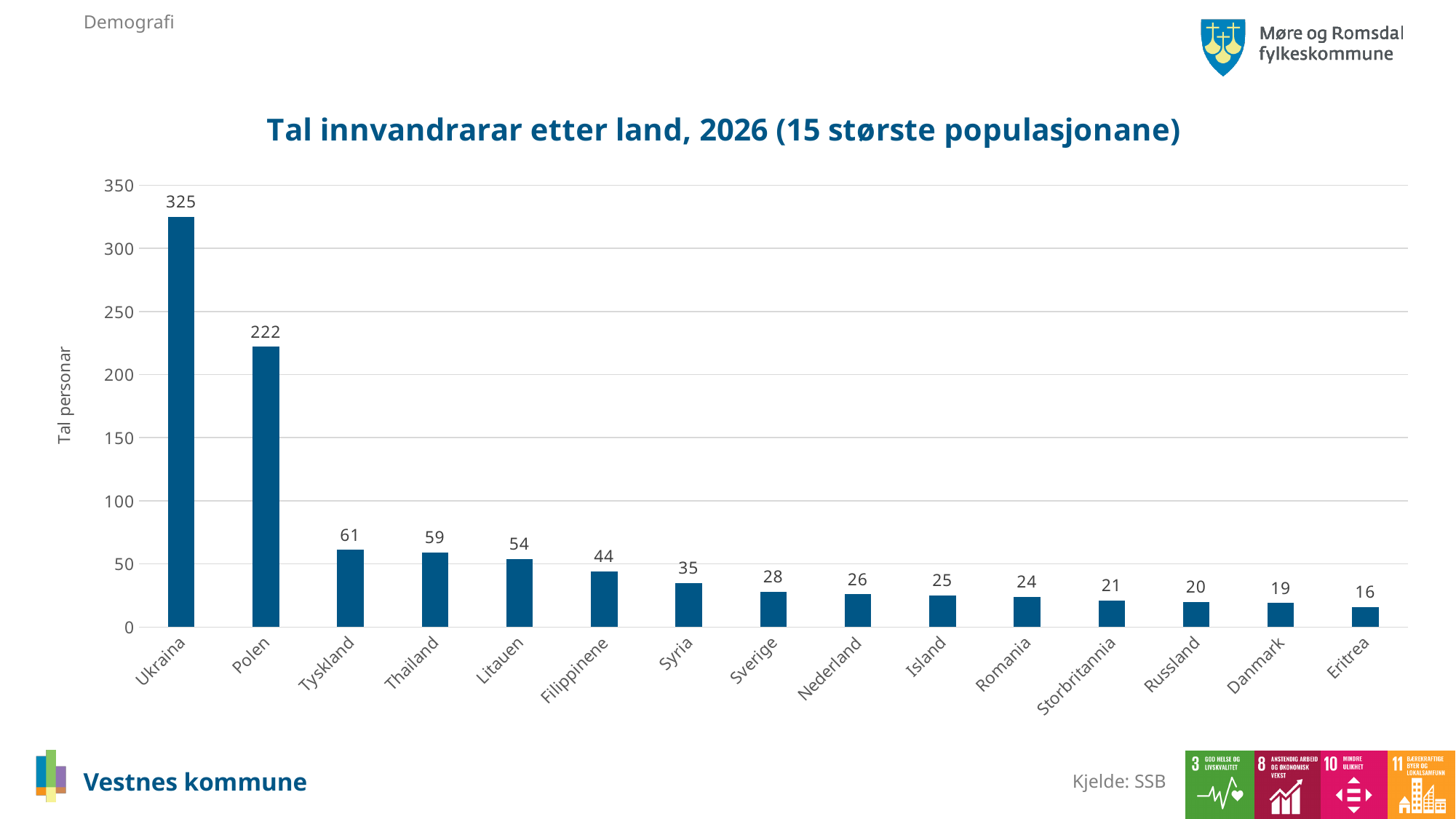
Which country has the lowest value? Eritrea What is the value for Thailand? 59 How many countries are shown on the chart? 15 What is the value for Storbritannia? 21 Which is larger, the value for Syria or the value for Sverige? Syria Is the value for Polen greater or less than 200? greater Which country has the highest value? Ukraina What is the difference between the values for Ukraina and Polen? 103 What is the value for Ukraina? 325 What is the difference between the values for Tyskland and Litauen? 7 What kind of chart is this? bar chart What is the title of the chart? Tal innvandrarar etter land, 2026 (15 største populasjonane)